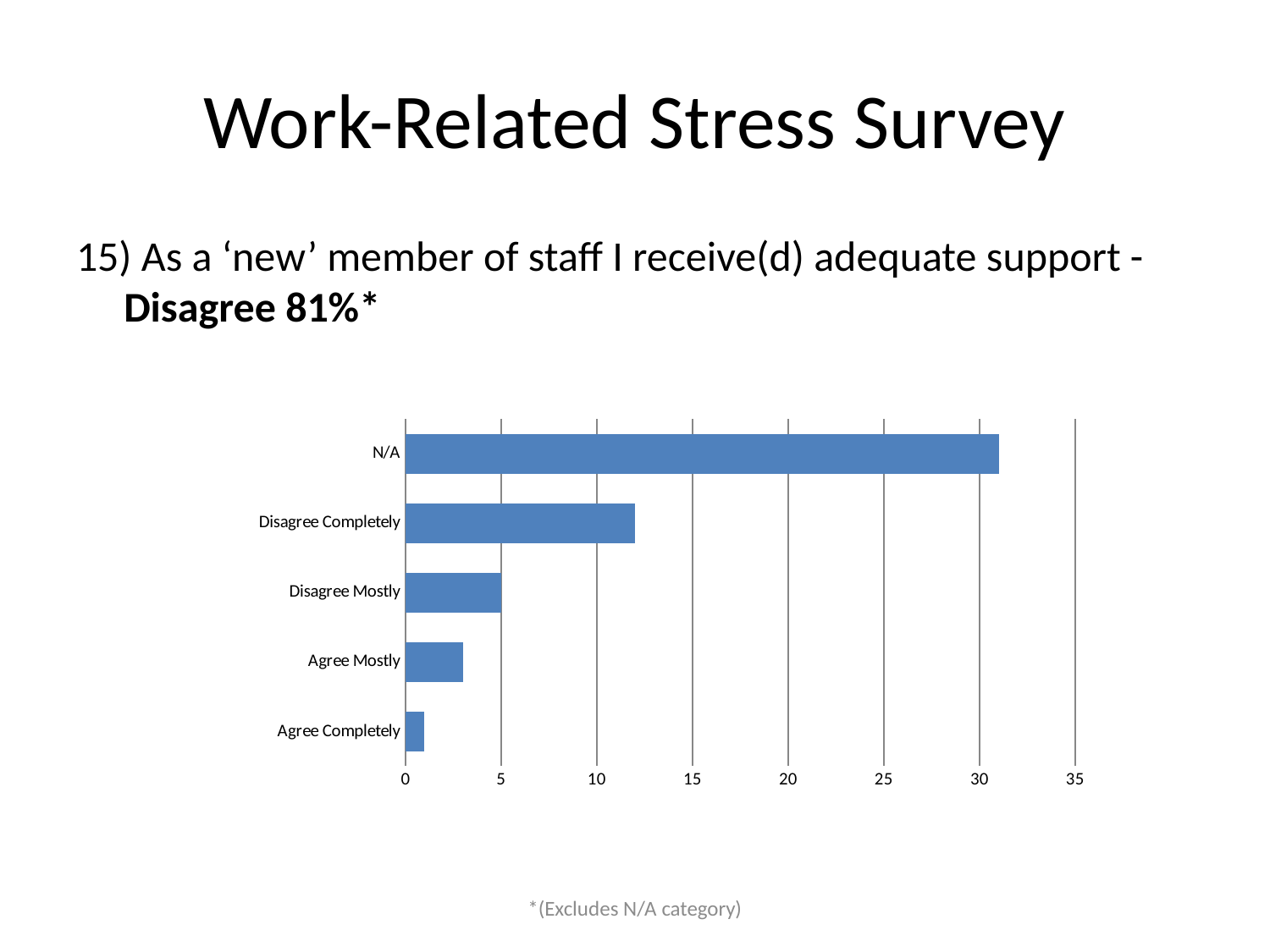
Is the value for Disagree Completely greater or less than 10? greater Which is larger, the value for Disagree Mostly or the value for Agree Completely? Disagree Mostly Is the value for N/A greater or less than 30? greater How many categories are shown in the chart? 5 Is the value for Agree Mostly greater or less than 5? less Which is larger, the value for Disagree Completely or the value for Agree Mostly? Disagree Completely Which category has the highest value in the chart? N/A Which category has the lowest value in the chart? Agree Completely What kind of chart is shown on the slide? bar chart What is the value for Disagree Mostly? 5 What is the highest value shown on the chart's horizontal axis? 35